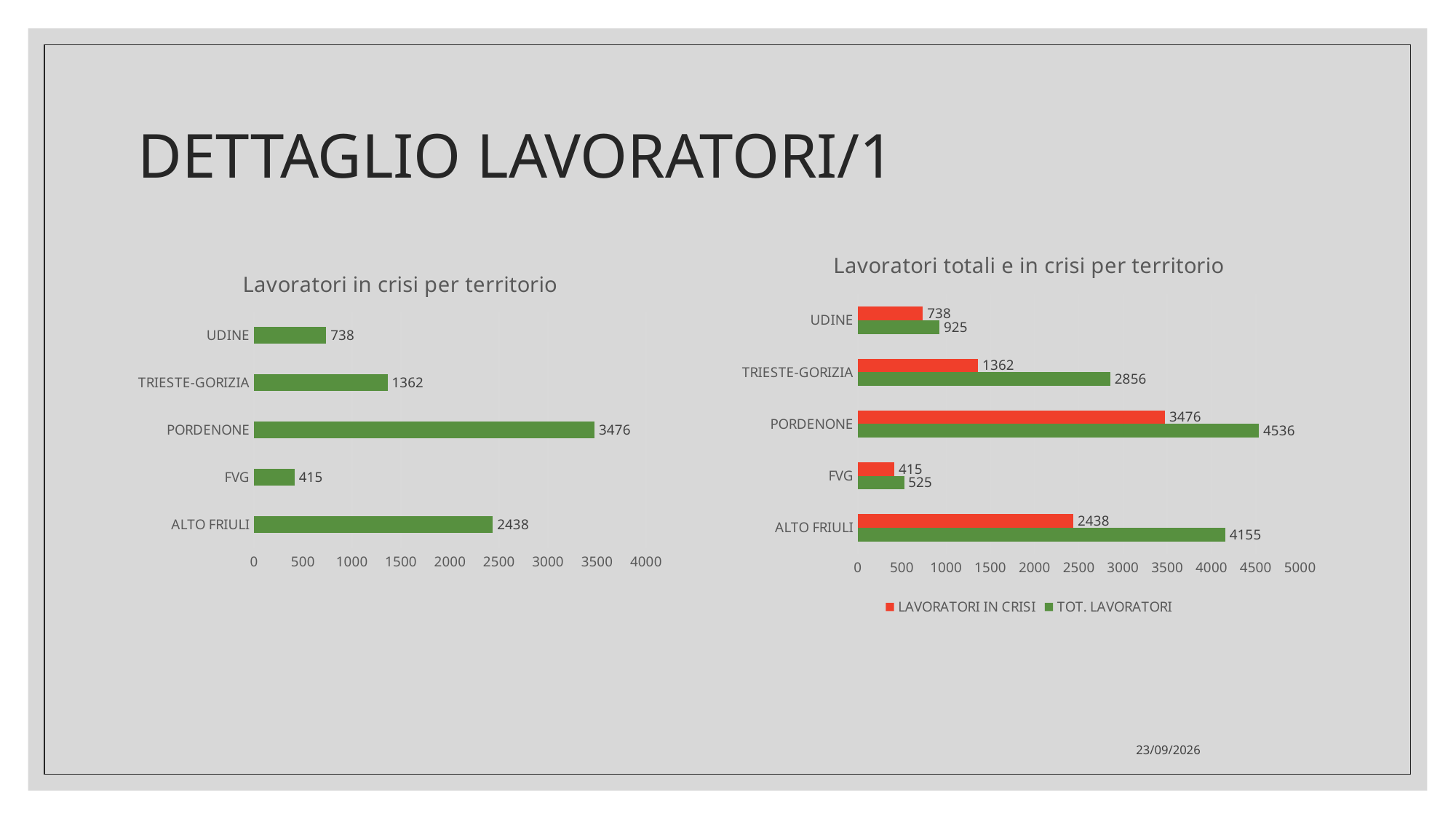
In the chart 'Lavoratori totali e in crisi per territorio', which territory has the highest TOT. LAVORATORI value? PORDENONE In the chart 'Lavoratori in crisi per territorio', what is the value for PORDENONE? 3476 In the chart 'Lavoratori in crisi per territorio', which territory has the highest value? PORDENONE In the chart 'Lavoratori in crisi per territorio', how many territories are shown? 5 In the chart 'Lavoratori totali e in crisi per territorio', which is larger: TOT. LAVORATORI for UDINE or TOT. LAVORATORI for FVG? UDINE In the chart 'Lavoratori totali e in crisi per territorio', how many series does the legend list? 2 What kind of chart is 'Lavoratori totali e in crisi per territorio'? Bar chart In the chart 'Lavoratori totali e in crisi per territorio', what is the LAVORATORI IN CRISI value for UDINE? 738 In the chart 'Lavoratori totali e in crisi per territorio', what is the TOT. LAVORATORI value for TRIESTE-GORIZIA? 2856 In the chart 'Lavoratori totali e in crisi per territorio', what is the difference between TOT. LAVORATORI and LAVORATORI IN CRISI for ALTO FRIULI? 1717 In the chart 'Lavoratori in crisi per territorio', which territory has the lowest value? FVG In the chart 'Lavoratori in crisi per territorio', what is the difference between ALTO FRIULI and TRIESTE-GORIZIA? 1076